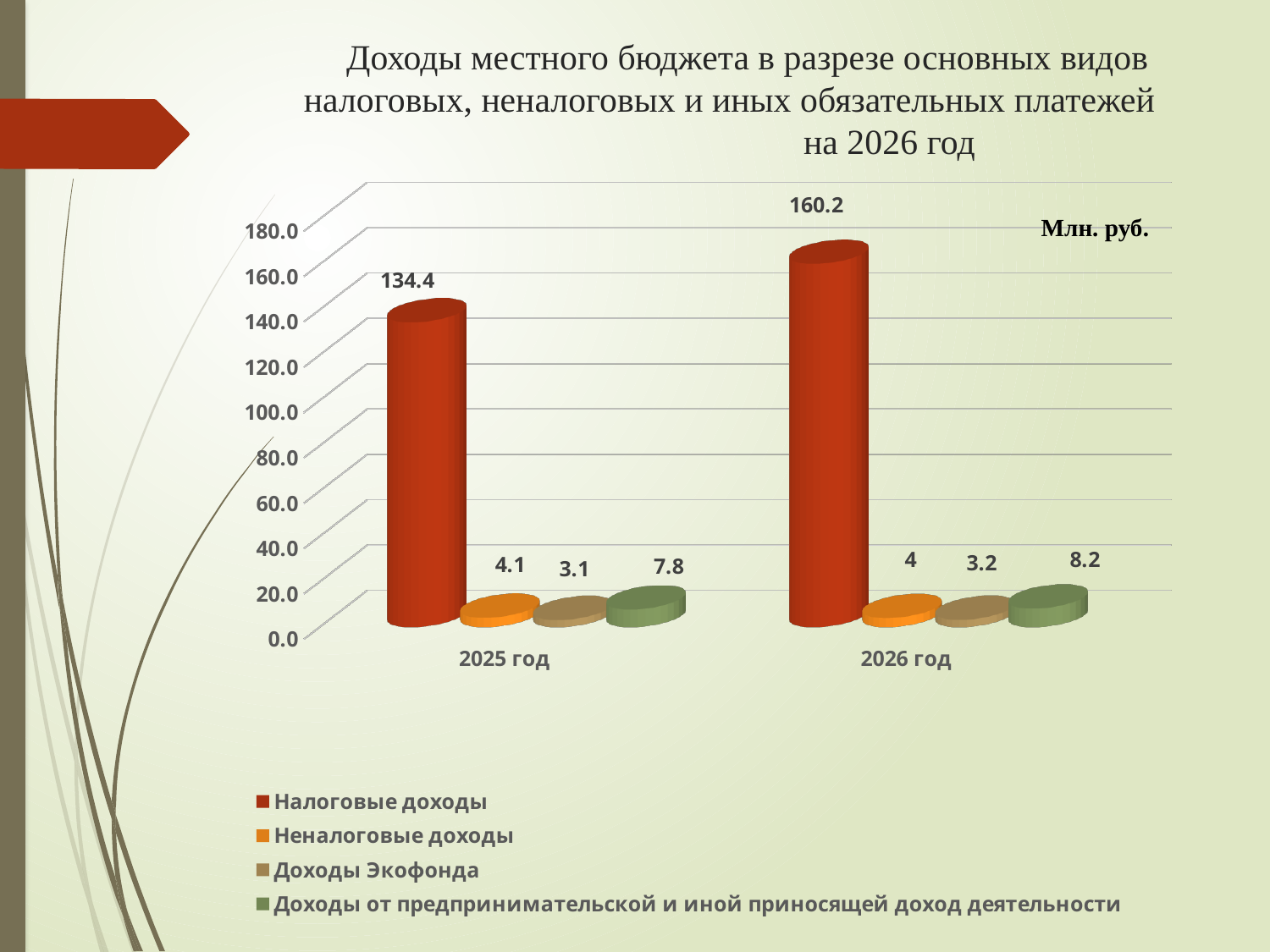
What is the difference between Налоговые доходы for 2026 год and 2025 год? 25.8 What kind of chart is shown on the slide? Bar chart What is the value of Налоговые доходы for 2026 год? 160.2 What is the value of Доходы Экофонда for 2025 год? 3.1 Which series has the lowest value for 2025 год? Доходы Экофонда How many series does the legend list? 4 Which is larger: Доходы от предпринимательской и иной приносящей доход деятельности for 2025 год or for 2026 год? 2026 год How many categories are shown on the x axis? 2 What is the value of Доходы от предпринимательской и иной приносящей доход деятельности for 2026 год? 8.2 Which series has the highest value for 2026 год? Налоговые доходы What is the value of Неналоговые доходы for 2026 год? 4 What is the value of Налоговые доходы for 2025 год? 134.4